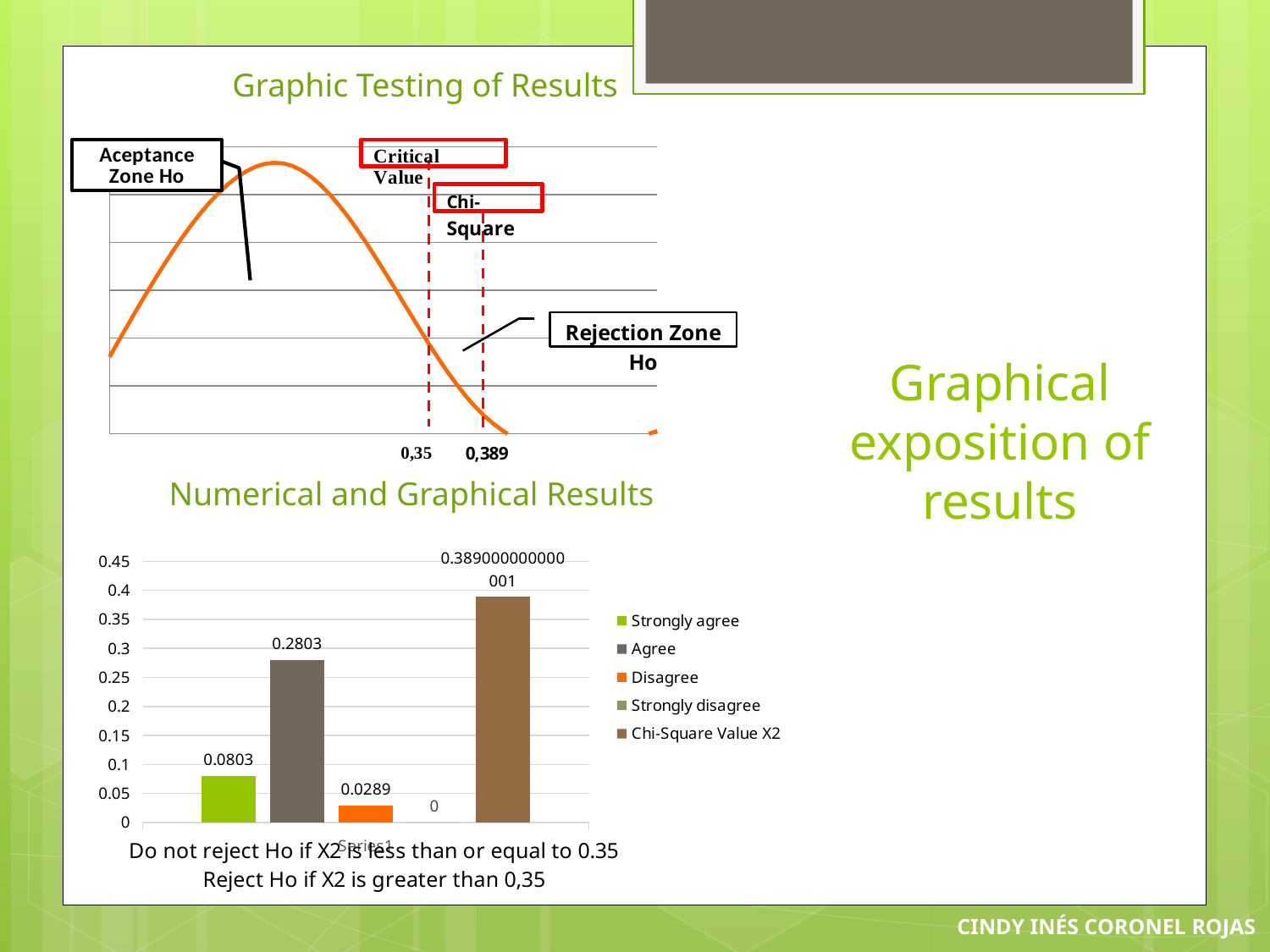
In the bottom chart titled 'Numerical and Graphical Results', what is the value for Agree? 0.2803 In the bottom chart titled 'Numerical and Graphical Results', which series has the lowest value? Strongly disagree In the bottom chart titled 'Numerical and Graphical Results', which is larger, the value for Strongly agree or the value for Disagree? Strongly agree How many series does the legend of the bottom chart titled 'Numerical and Graphical Results' list? 5 In the bottom chart titled 'Numerical and Graphical Results', is the value for Chi-Square Value X2 greater or less than 0.35? greater What kind of chart is the bottom chart titled 'Numerical and Graphical Results'? bar chart In the bottom chart titled 'Numerical and Graphical Results', what is the value for Strongly agree? 0.0803 In the bottom chart titled 'Numerical and Graphical Results', which series has the highest value? Chi-Square Value X2 In the bottom chart titled 'Numerical and Graphical Results', what is the value for Disagree? 0.0289 In the top chart titled 'Graphic Testing of Results', what critical value is marked on the x axis? 0,35 In the bottom chart titled 'Numerical and Graphical Results', what is the value for Strongly disagree? 0 In the bottom chart titled 'Numerical and Graphical Results', what is the difference between the Agree value and the Strongly agree value? 0.2